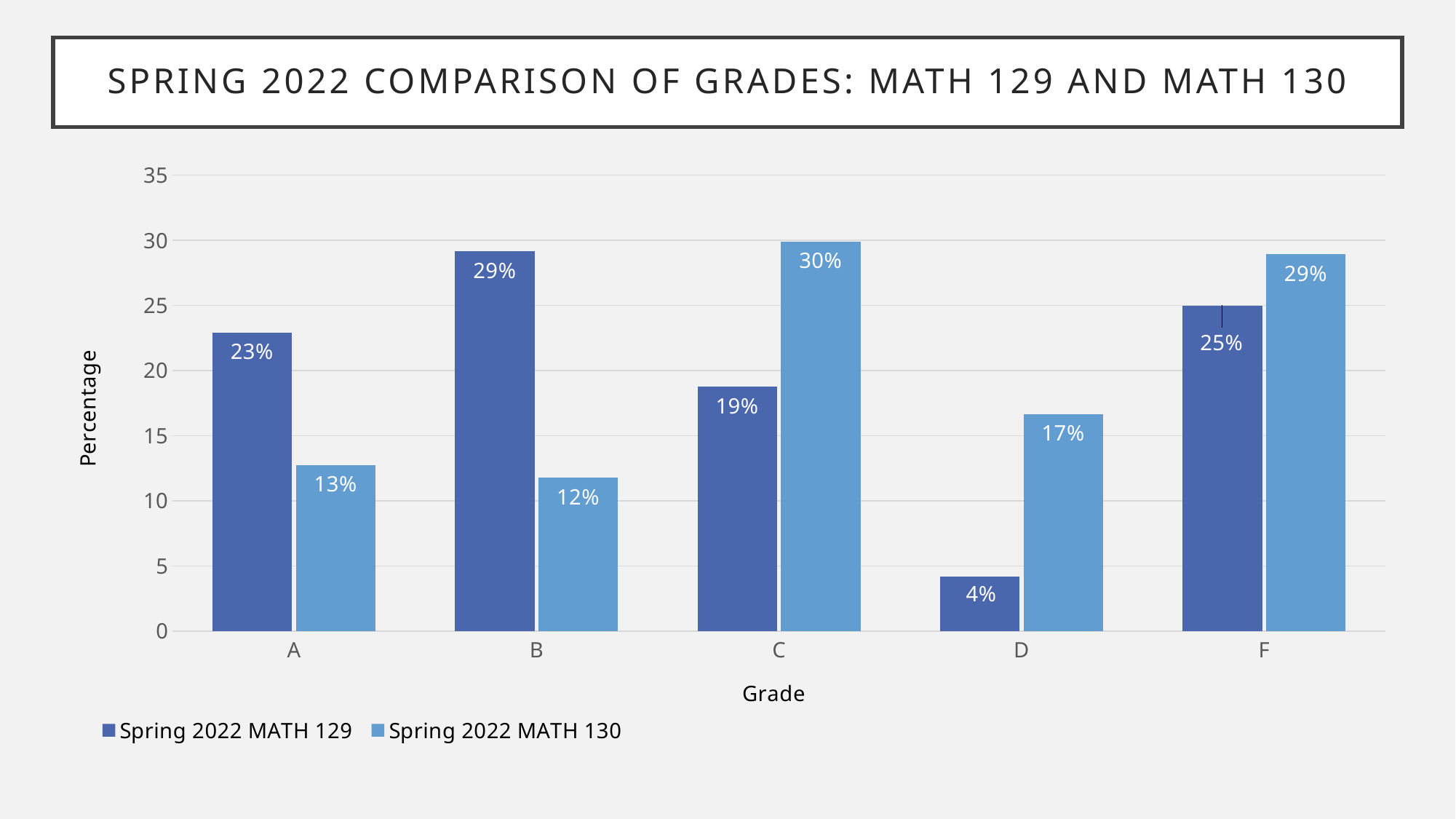
How many series does the legend list? 2 What percentage of Spring 2022 MATH 130 students received a grade of C? 30% What percentage of Spring 2022 MATH 129 students received a grade of A? 23% Which grade has the highest percentage for Spring 2022 MATH 129? B What percentage of Spring 2022 MATH 130 students received a grade of D? 17% Which grade has the lowest percentage for Spring 2022 MATH 129? D What is the difference between the MATH 130 and MATH 129 percentages for grade D? 13% What kind of chart is shown on the slide? Bar chart Is the Spring 2022 MATH 129 value for grade C greater or less than 20? less For grade F, which course has the larger percentage, MATH 129 or MATH 130? Spring 2022 MATH 130 Which grade has the lowest percentage for Spring 2022 MATH 130? B How many grade categories are shown on the x axis? 5